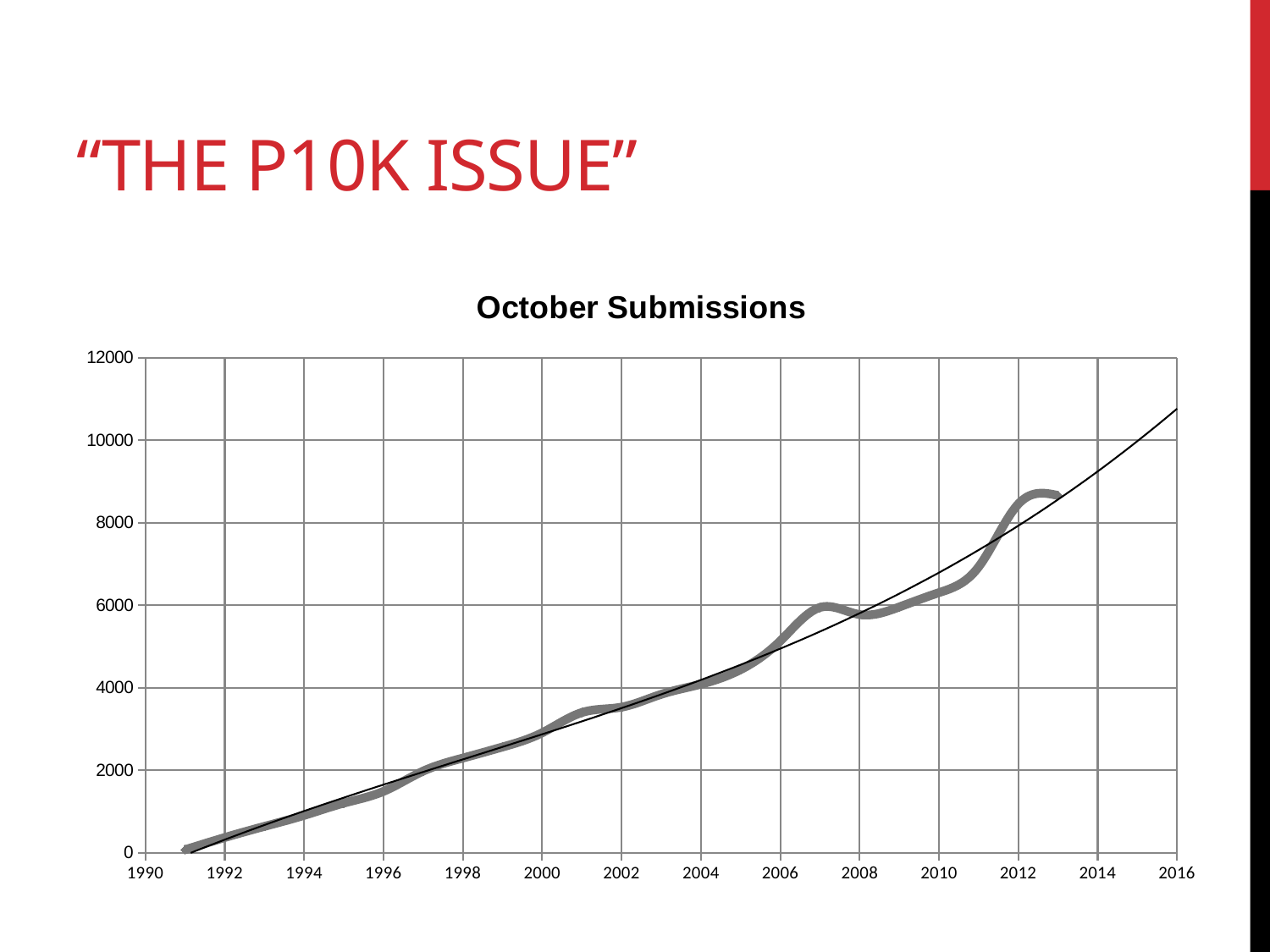
What is the highest value shown on the vertical axis of the chart? 12000 What is the title of the chart? October Submissions Is the October Submissions value for 2004 greater or less than 6000? less Is the October Submissions value for 2000 greater or less than 4000? less Do the October Submissions values rise or fall from 1991 to 2013? rise Is the October Submissions value for 1996 greater or less than 2000? less Which year has the higher October Submissions value, 2002 or 2012? 2012 What kind of chart is shown on the slide? line chart How many lines are plotted on the chart? 2